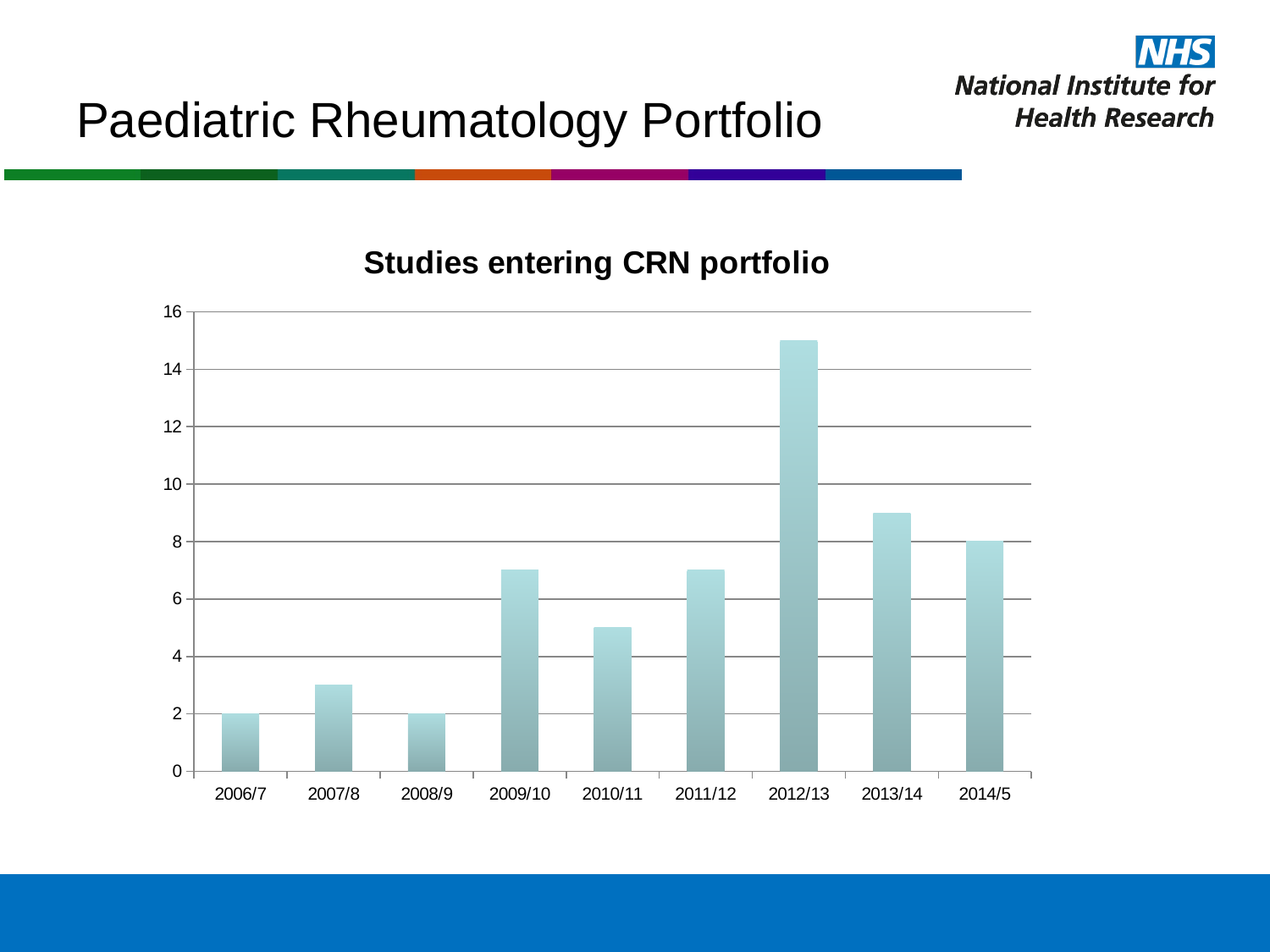
What kind of chart is shown on the slide? bar chart How many years (categories) are shown on the x axis of the chart? 9 Which year has the highest number of studies entering the CRN portfolio? 2012/13 Is the value for 2010/11 greater or less than 6? less What is the title of the chart? Studies entering CRN portfolio What is the value for 2014/5? 8 What is the difference between the value for 2014/5 and the value for 2006/7? 6 Is the value for 2012/13 greater or less than 14? greater Which is larger, the value for 2012/13 or the value for 2013/14? 2012/13 What is the value for 2008/9? 2 What is the value for 2006/7? 2 Do the values rise or fall from 2012/13 to 2014/5? fall